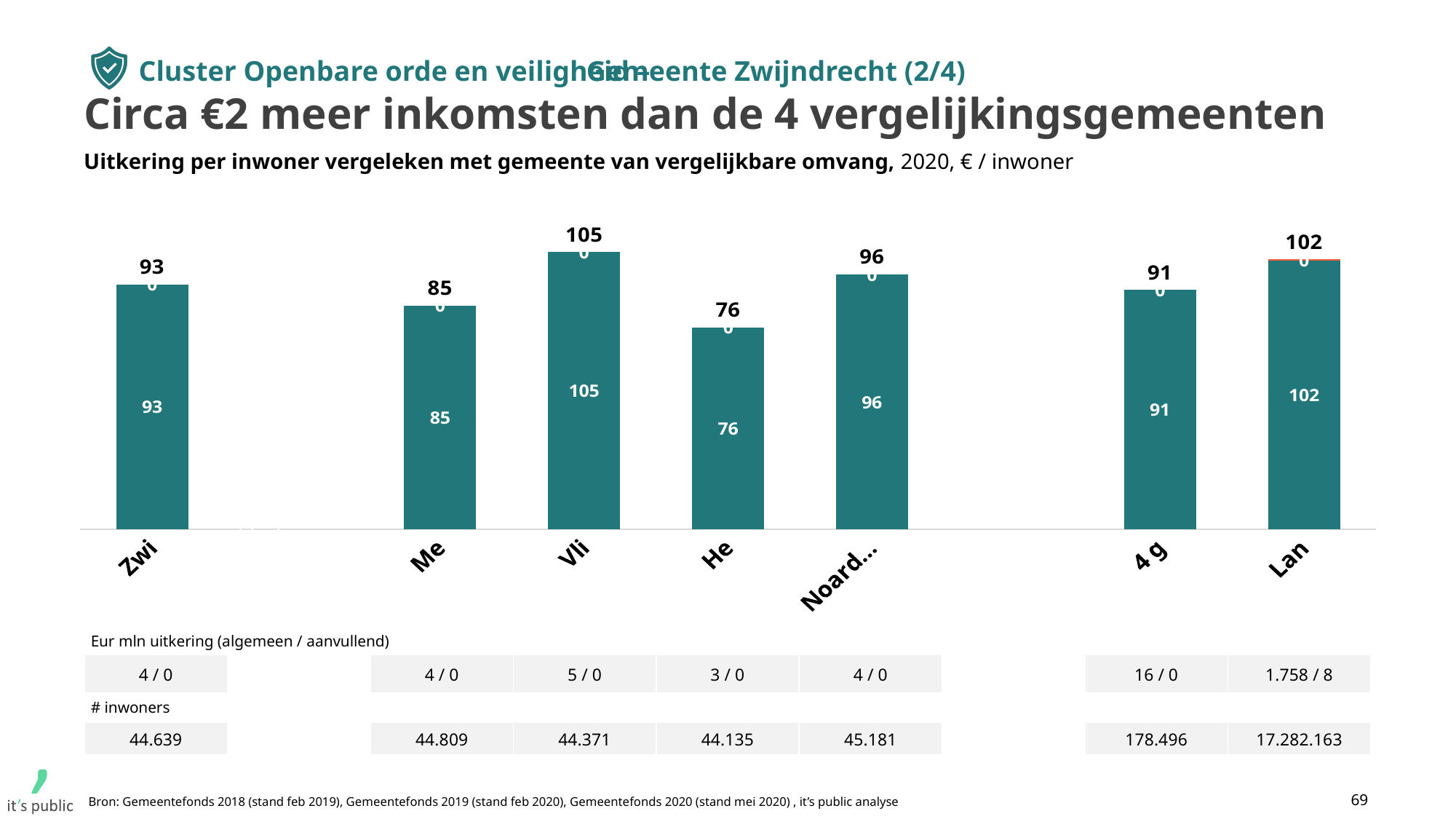
Which category has the lowest value? He What is the difference between the values for Vli and He? 29 What is the difference between the values for Zwi and 4 g? 2 Which category has the highest value? Vli Which is larger, the value for Me or the value for Noard...? Noard... What is the value shown for Lan? 102 What unit is stated in the chart subtitle? € / inwoner What is the value shown for Zwi? 93 How many bars are shown in the chart? 7 What kind of chart is shown on the slide? Bar chart What is the value shown for He? 76 What is the value shown for Vli? 105